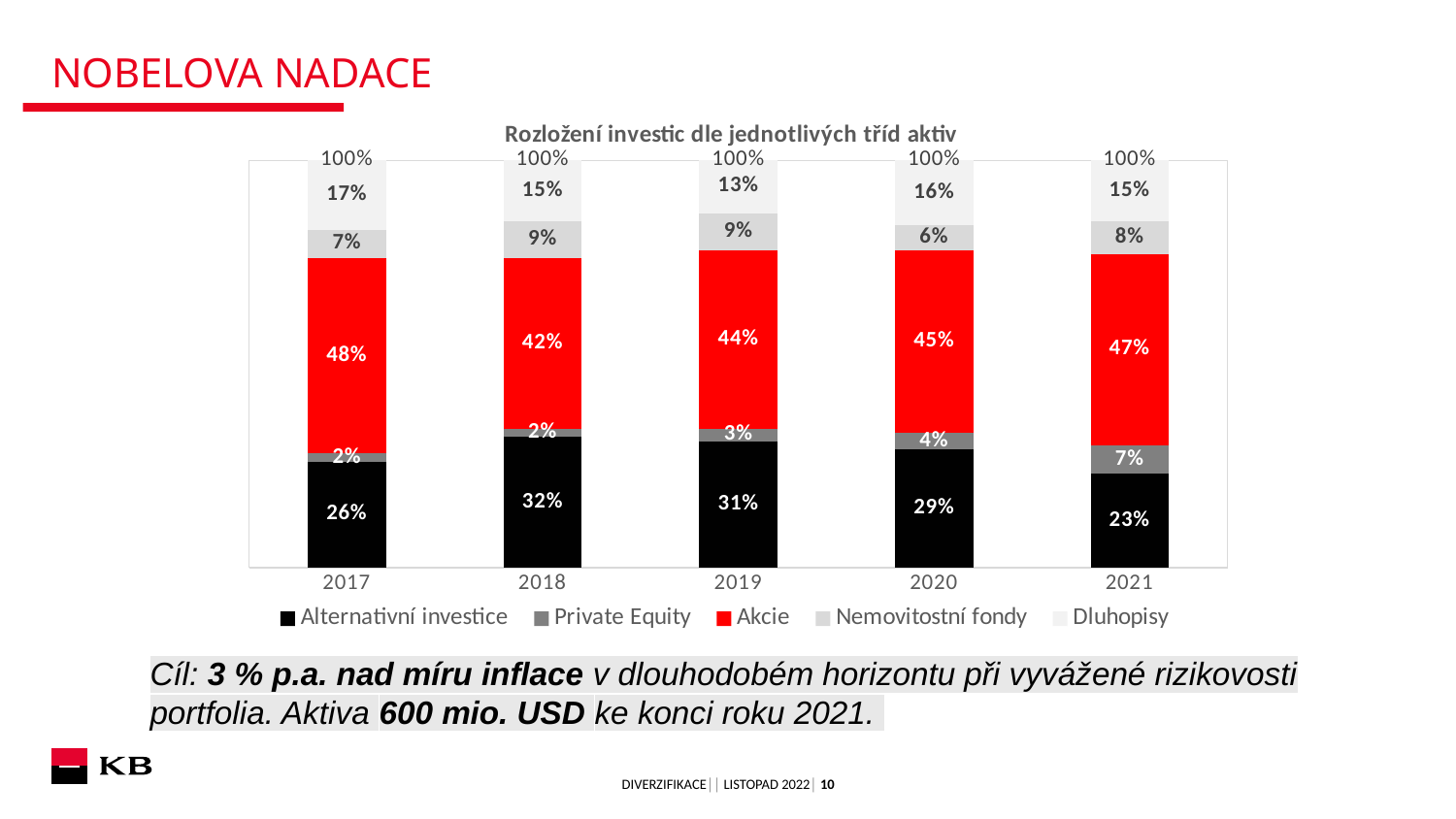
What kind of chart is shown? Stacked bar chart In which year is the Alternativní investice share highest? 2018 Which is larger, the Nemovitostní fondy share in 2018 or in 2020? 2018 How many series does the legend list? 5 In which year is the Akcie share lowest? 2018 What is the difference between the Akcie share in 2021 and in 2018? 5% What is the value for Akcie in 2017? 48% What is the value for Alternativní investice in 2021? 23% What is the value for Dluhopisy in 2019? 13% How many years are shown on the x axis? 5 What is the value for Private Equity in 2020? 4% What is the total of the stacked bar for 2020? 100%